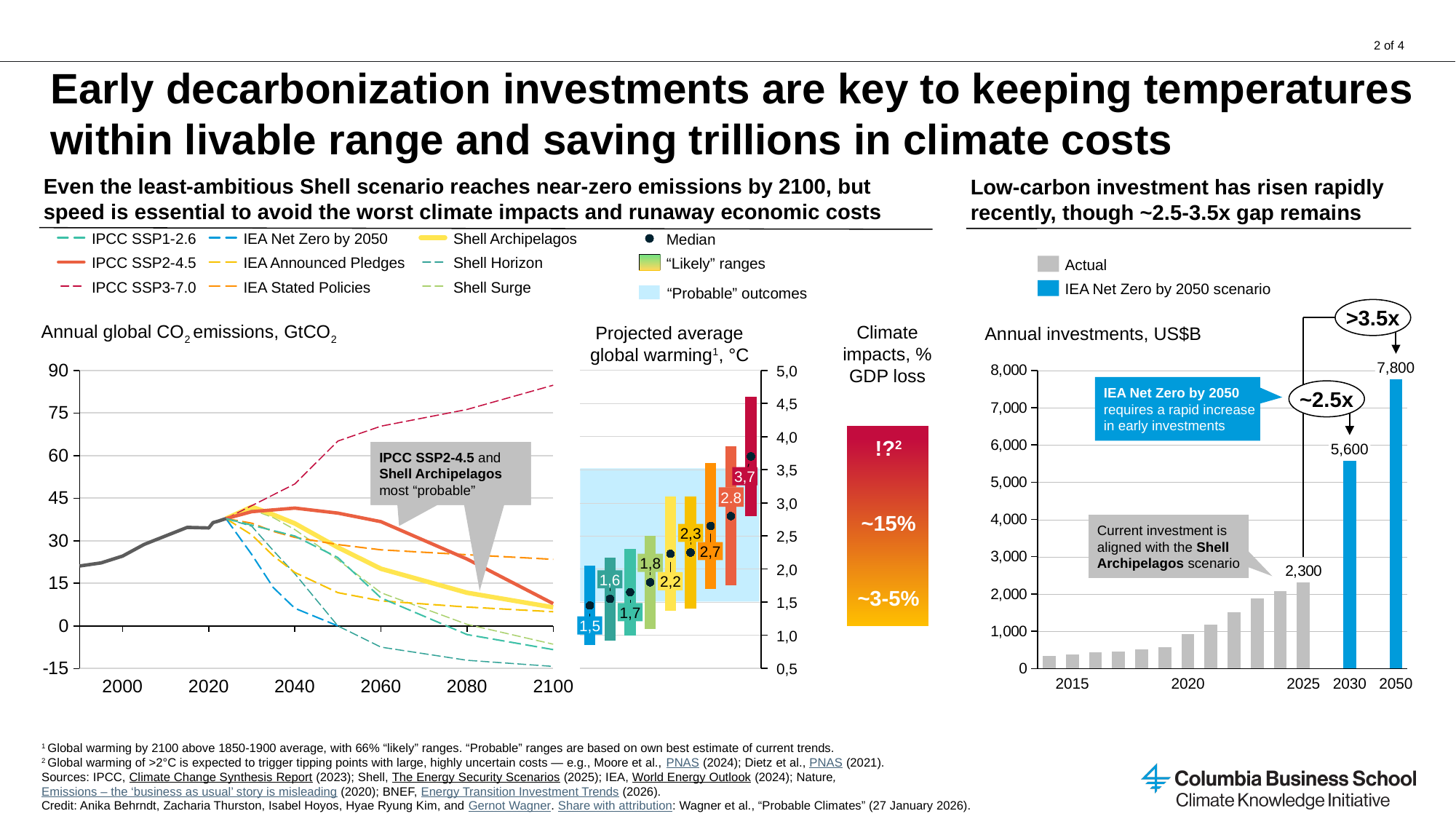
In the 'Annual investments, US$B' chart, do the values rise or fall from 2015 to 2050? Rise In the 'Annual global CO2 emissions, GtCO2' chart, which scenario has the highest emissions in 2100? IPCC SSP3-7.0 In the 'Annual investments, US$B' chart, what is the difference between the 2030 and 2025 values? 3,300 In the 'Annual investments, US$B' chart, what is the value for 2050? 7,800 What kind of chart is the 'Annual investments, US$B' chart? Bar chart In the 'Projected average global warming, °C' chart, what is the lowest median value shown? 1,5 In the 'Annual investments, US$B' chart, what is the value for 2025? 2,300 In the 'Projected average global warming, °C' chart, what is the highest median value shown? 3,7 In the 'Annual investments, US$B' chart, what is the difference between the 2050 and 2030 values? 2,200 In the 'Annual investments, US$B' chart, what is the value for 2030? 5,600 How many series does the legend of the 'Annual investments, US$B' chart list? 2